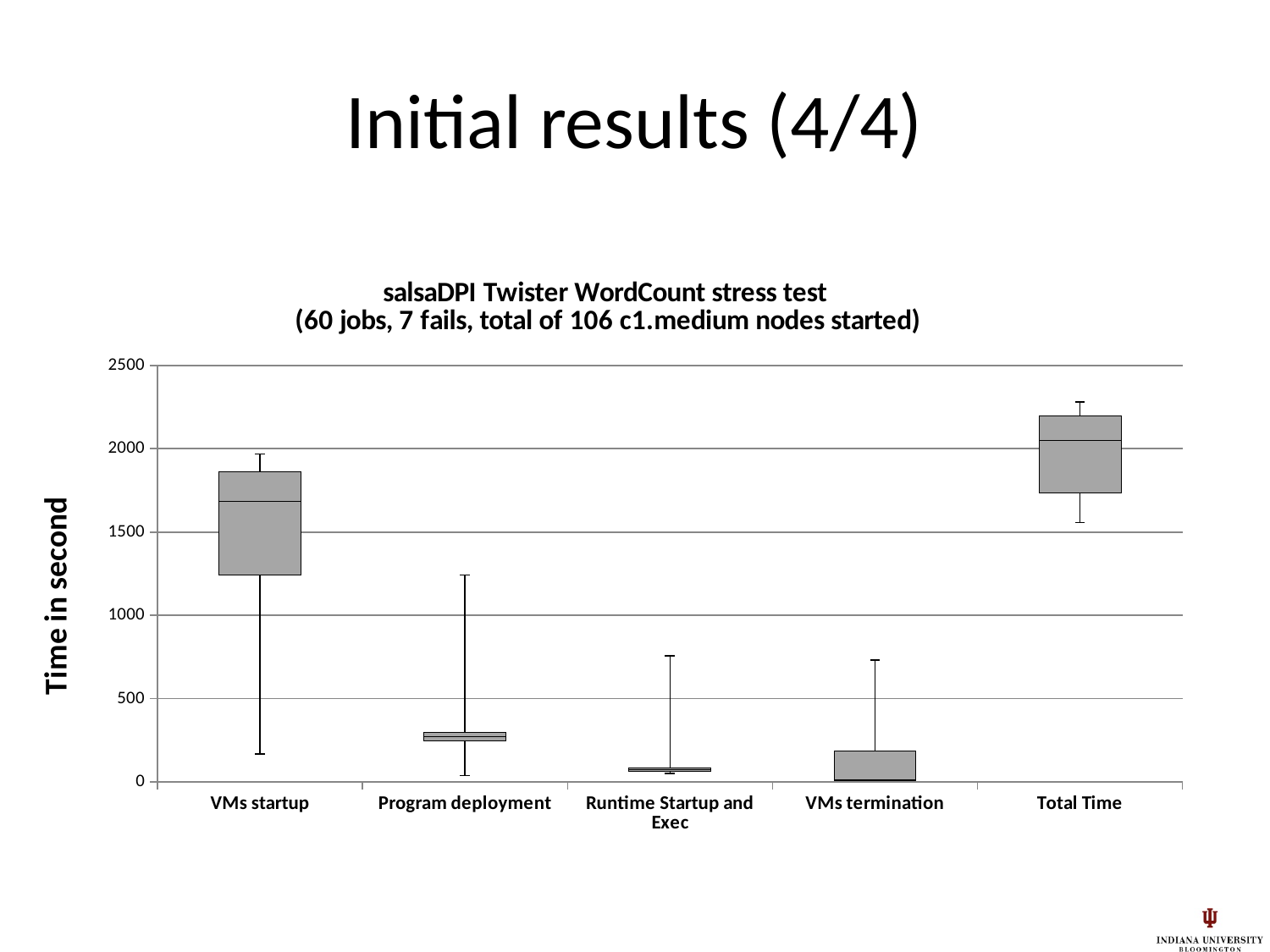
How many categories are shown on the x axis of the chart? 5 What is the title of the chart? salsaDPI Twister WordCount stress test (60 jobs, 7 fails, total of 106 c1.medium nodes started) Which has the larger median time, Total Time or VMs startup? Total Time Which category has the lowest median time? VMs termination Is the upper whisker (maximum) for Total Time greater or less than 2500? less What kind of chart is shown on the slide? Box plot (box-and-whisker chart) What is the label of the y axis? Time in second Is the median value for Program deployment greater or less than 500? less Is the upper whisker (maximum) for Program deployment greater or less than 1000? greater Which has the larger median time, VMs startup or Program deployment? VMs startup Which category has the highest median time? Total Time